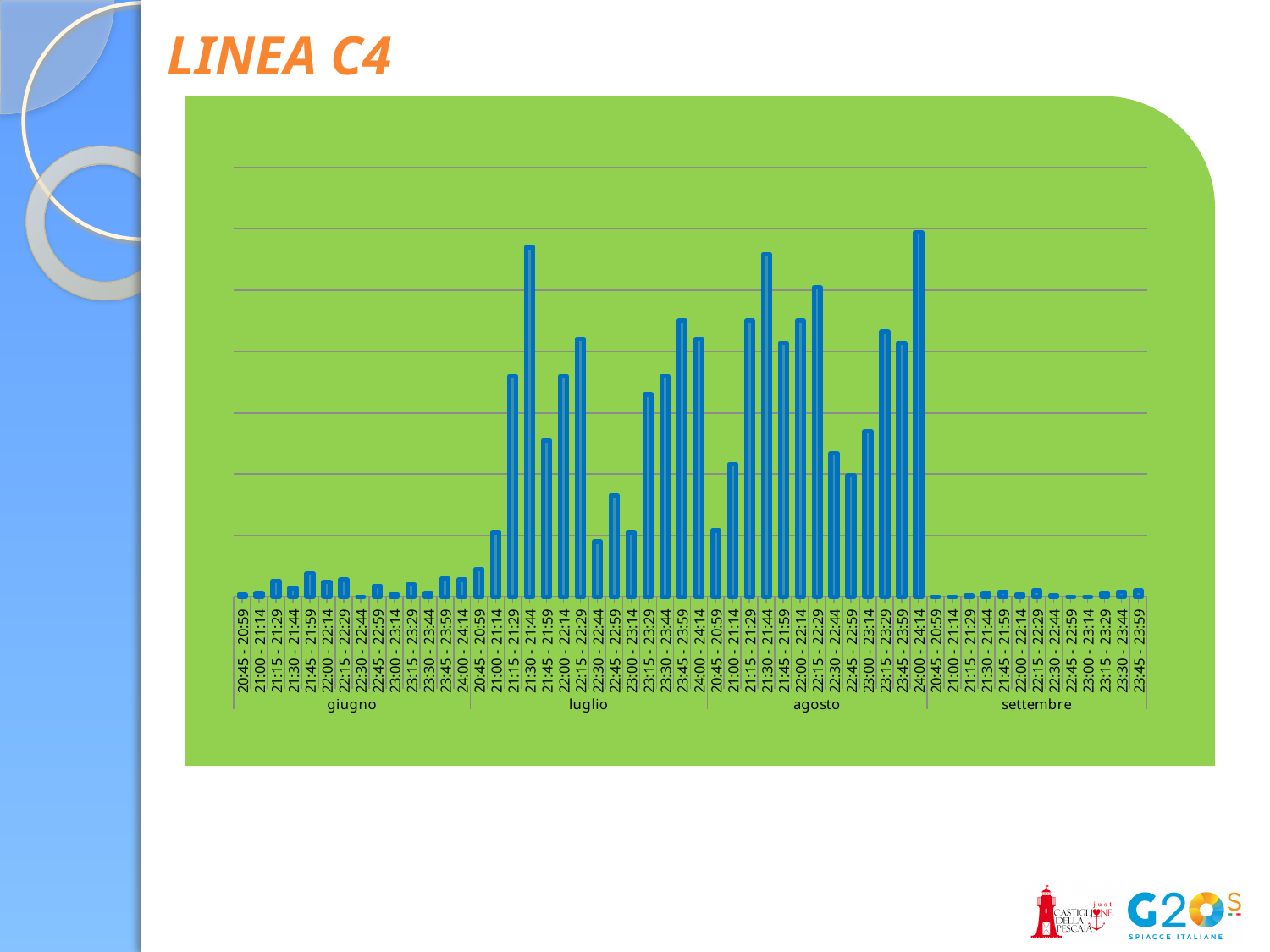
What kind of chart is shown on the slide? bar chart What is the title of the slide containing the chart? LINEA C4 In agosto, which is larger: the bar for 22:15 - 22:29 or the bar for 22:45 - 22:59? 22:15 - 22:29 Which month groups are labelled along the x axis of the chart? giugno, luglio, agosto, settembre Which time slot has the tallest bar in the chart? 24:00 - 24:14 in agosto In luglio, which is larger: the bar for 21:30 - 21:44 or the bar for 22:45 - 22:59? 21:30 - 21:44 How many month groups are shown along the x axis of the chart? 4 Which month group has the lowest bars overall in the chart? settembre Which month group contains the tallest bar in the chart? agosto Which is larger: the bar for 21:30 - 21:44 in luglio or the bar for 21:30 - 21:44 in giugno? luglio In luglio, do the bars rise or fall from 20:45 - 20:59 to 21:30 - 21:44? rise